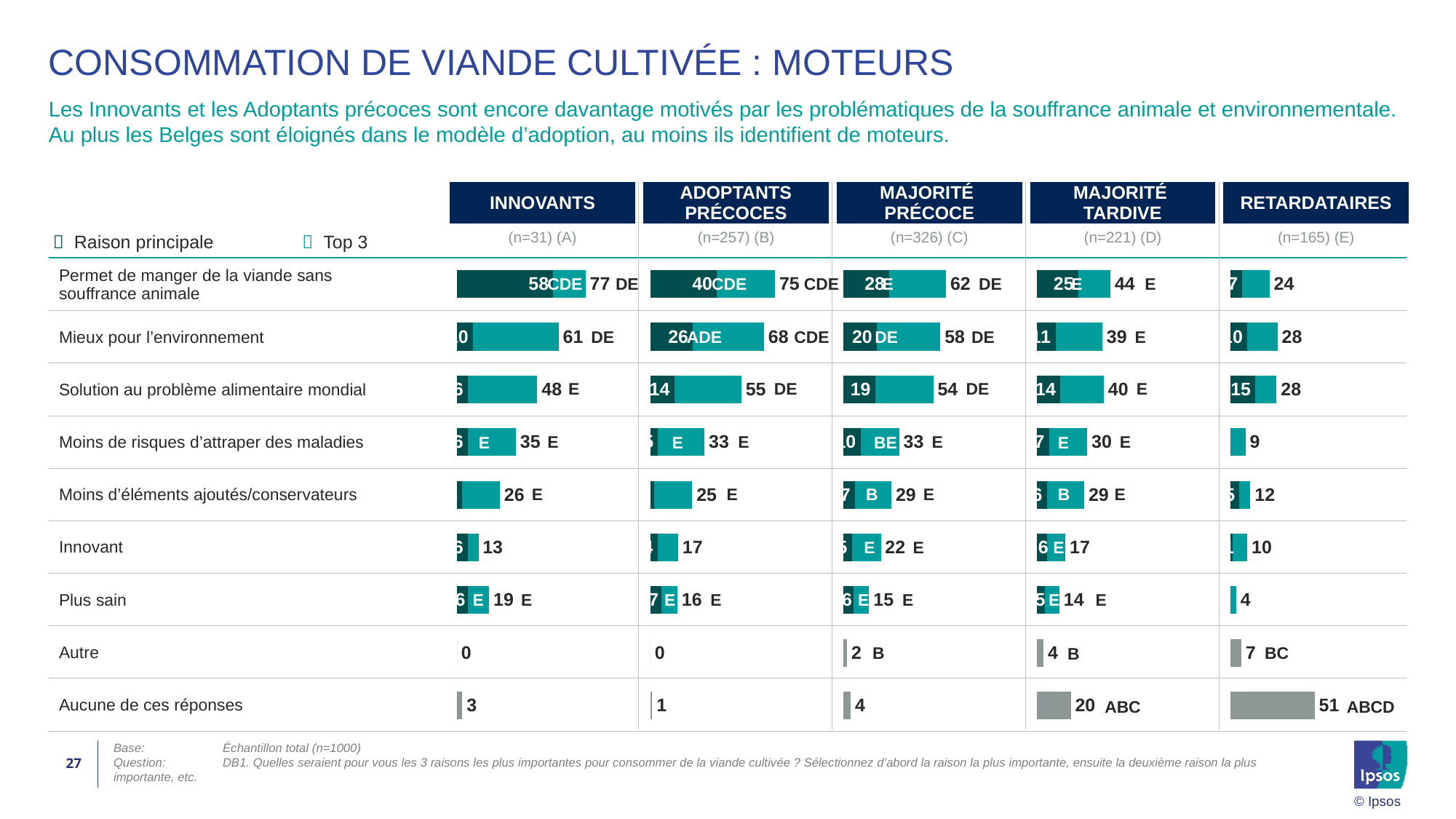
What is the Top 3 value for "Aucune de ces réponses" among the Retardataires (E)? 51 Which reason has the lowest Top 3 value among the Retardataires (E)? Plus sain What is the Top 3 value for "Permet de manger de la viande sans souffrance animale" among the Innovants (A)? 77 How many reasons (rows) are listed in the chart? 9 What is the "Raison principale" value for "Permet de manger de la viande sans souffrance animale" among the Innovants (A)? 58 Which is larger: the Top 3 value for "Solution au problème alimentaire mondial" among the Adoptants précoces (B) or among the Majorité tardive (D)? Adoptants précoces (B) What is the sample size (n) for the Majorité tardive (D) group? n=221 What is the difference between the Top 3 values for "Permet de manger de la viande sans souffrance animale" among the Innovants (A) and the Retardataires (E)? 53 How many segment groups (columns) are shown in the chart? 5 Which reason has the highest Top 3 value among the Majorité précoce (C)? Permet de manger de la viande sans souffrance animale What is the Top 3 value for "Mieux pour l'environnement" among the Adoptants précoces (B)? 68 What kind of chart is used to display the values? Bar chart